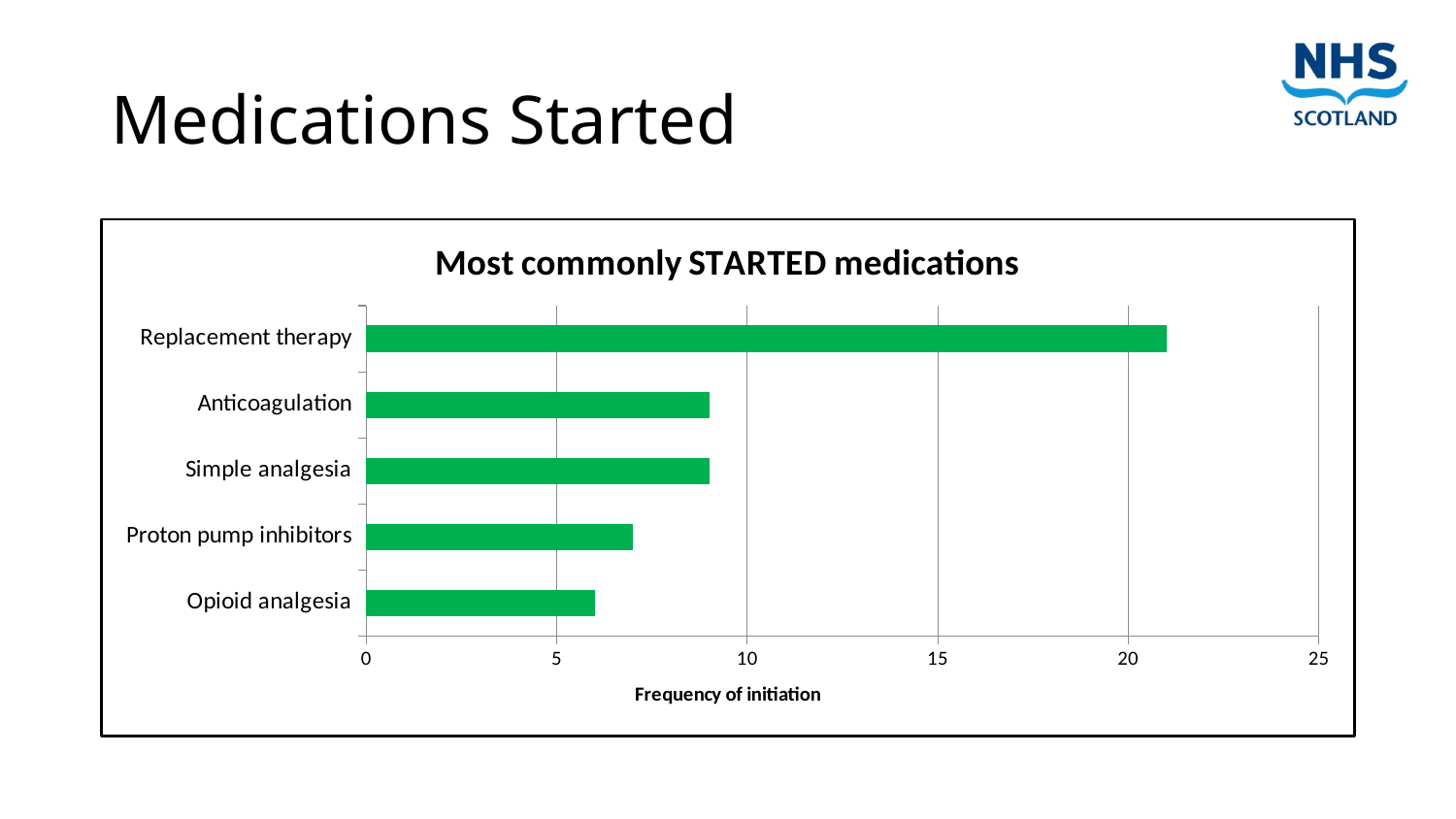
Which has a higher frequency of initiation, Replacement therapy or Anticoagulation? Replacement therapy Which medication category has the highest frequency of initiation? Replacement therapy Is the value for Opioid analgesia greater or less than 5? greater What is the label on the horizontal axis of the chart? Frequency of initiation What kind of chart is shown on the slide? bar chart Is the value for Replacement therapy greater or less than 25? less Is the value for Simple analgesia greater or less than 5? greater How many medication categories are plotted in the chart? 5 What is the title of the chart? Most commonly STARTED medications